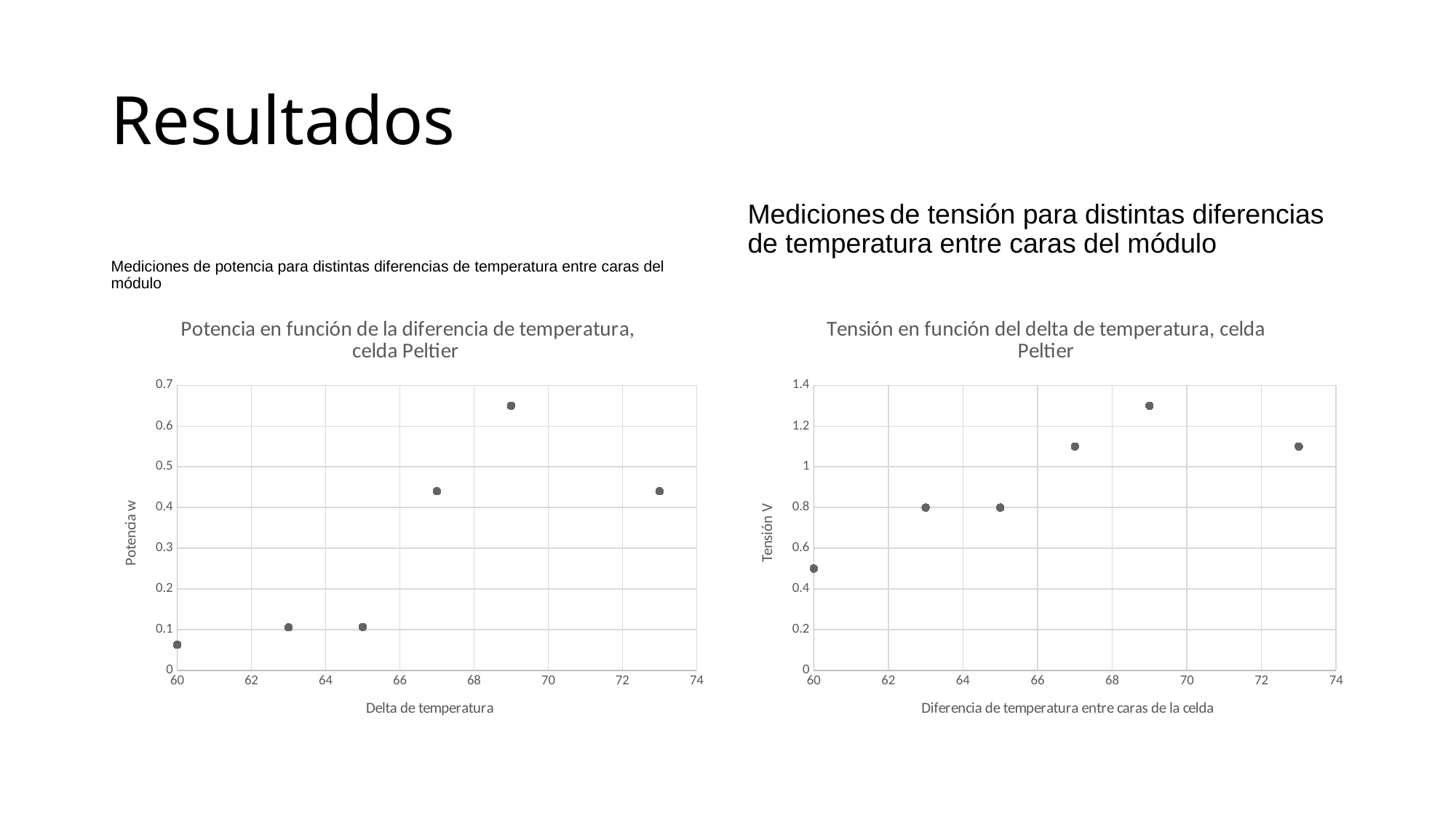
In the left chart, 'Potencia en función de la diferencia de temperatura, celda Peltier', is the power at a delta of 69 greater or less than 0.6? greater In the left chart, 'Potencia en función de la diferencia de temperatura, celda Peltier', at which delta de temperatura is the power lowest? 60 In the right chart, 'Tensión en función del delta de temperatura, celda Peltier', is the voltage at a temperature difference of 69 greater or less than 1.2? greater How many data points are plotted in the right chart, 'Tensión en función del delta de temperatura, celda Peltier'? 6 In the left chart, 'Potencia en función de la diferencia de temperatura, celda Peltier', is the power at a delta of 60 greater or less than 0.1? less In the left chart, 'Potencia en función de la diferencia de temperatura, celda Peltier', at which delta de temperatura is the power highest? 69 In the left chart, 'Potencia en función de la diferencia de temperatura, celda Peltier', which has the higher power: a delta of 69 or a delta of 73? 69 In the right chart, 'Tensión en función del delta de temperatura, celda Peltier', at which temperature difference is the voltage highest? 69 What kind of chart is the left chart, 'Potencia en función de la diferencia de temperatura, celda Peltier'? scatter chart What is the y-axis title of the right chart, 'Tensión en función del delta de temperatura, celda Peltier'? Tensión V How many data points are plotted in the left chart, 'Potencia en función de la diferencia de temperatura, celda Peltier'? 6 In the right chart, 'Tensión en función del delta de temperatura, celda Peltier', at which temperature difference is the voltage lowest? 60